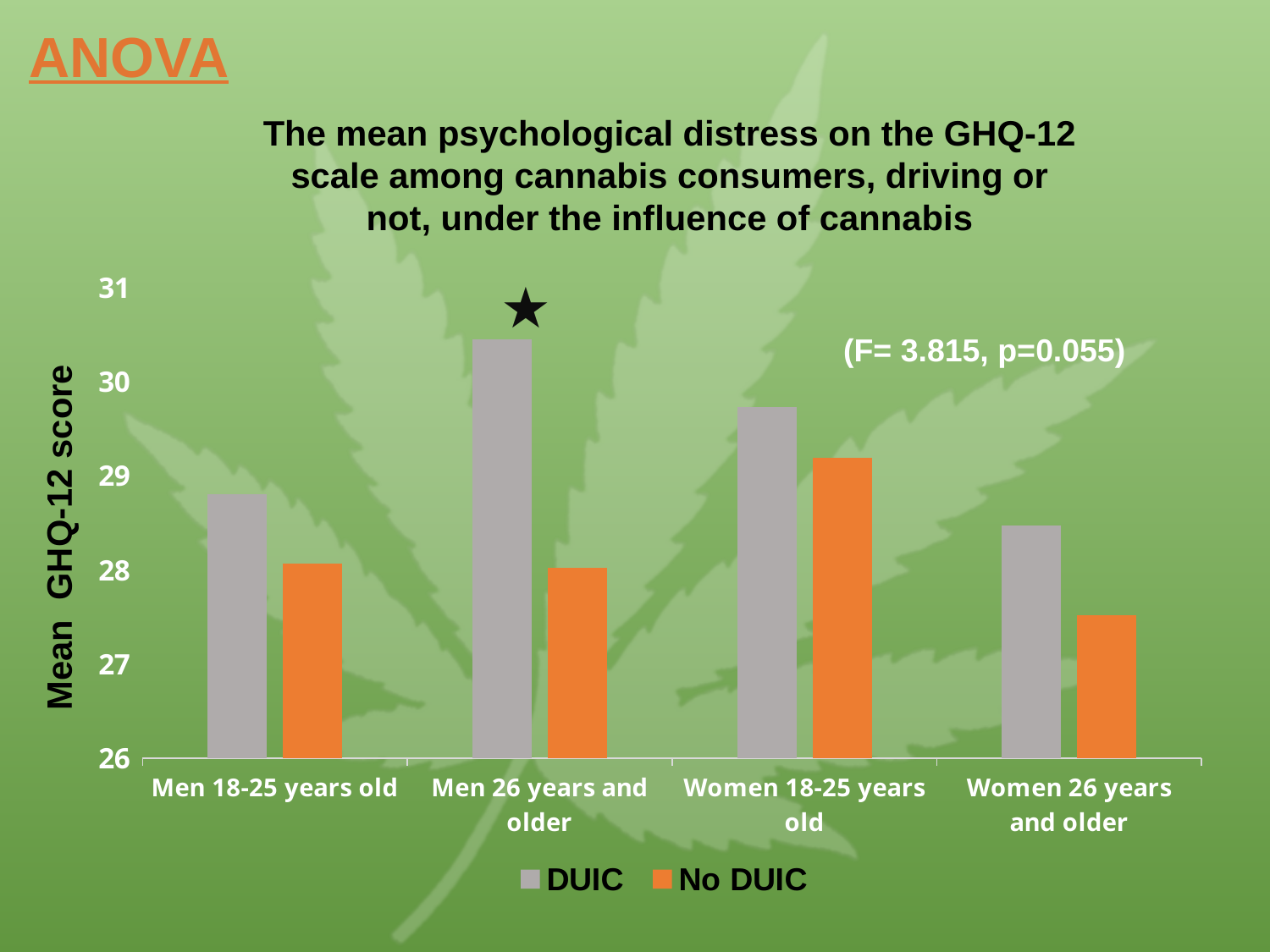
What F statistic and p-value are printed on the chart? F= 3.815, p=0.055 Is the DUIC value for Women 18-25 years old greater or less than 29? greater Which group has the highest No DUIC mean GHQ-12 score? Women 18-25 years old What kind of chart is shown on the slide? bar chart Which group has the lowest No DUIC mean GHQ-12 score? Women 26 years and older Which group has the highest DUIC mean GHQ-12 score? Men 26 years and older Is the DUIC value for Men 26 years and older greater or less than 30? greater Which series is shown in orange in the legend? No DUIC How many series does the legend list? 2 Is the No DUIC value for Women 26 years and older greater or less than 28? less For Men 26 years and older, which is larger: the DUIC or the No DUIC mean GHQ-12 score? DUIC How many age/sex groups are shown on the x axis? 4